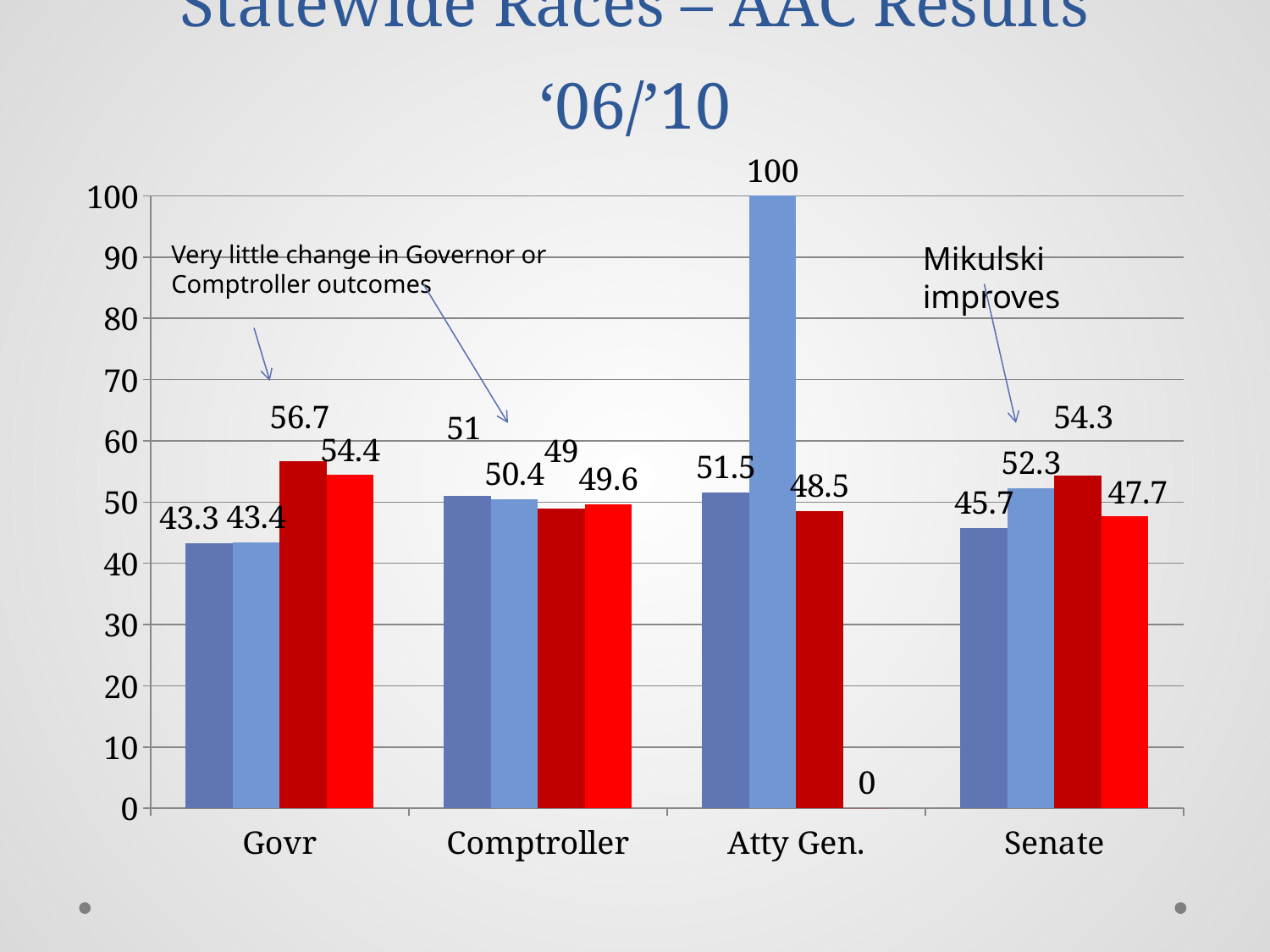
Which category has the tallest bar in the chart? Atty Gen. Is the value of the dark red bar for Comptroller greater or less than 50? less How many categories are shown on the x axis of the chart? 4 What is the title of the chart on the slide? Statewide Races – AAC Results '06/'10 What is the value of the dark red (third) bar for Govr? 56.7 What is the lowest value labelled in the chart, and for which category? 0, Atty Gen. Which is larger for Senate: the light blue bar or the dark blue bar? the light blue bar (52.3) What is the value of the bright red (fourth) bar for Senate? 47.7 What is the value of the first (dark blue) bar for Comptroller? 51 What type of chart is shown on the slide? bar chart What is the value of the light blue (second) bar for Atty Gen.? 100 What is the difference between the dark red bar (56.7) and the dark blue bar (43.3) for Govr? 13.4